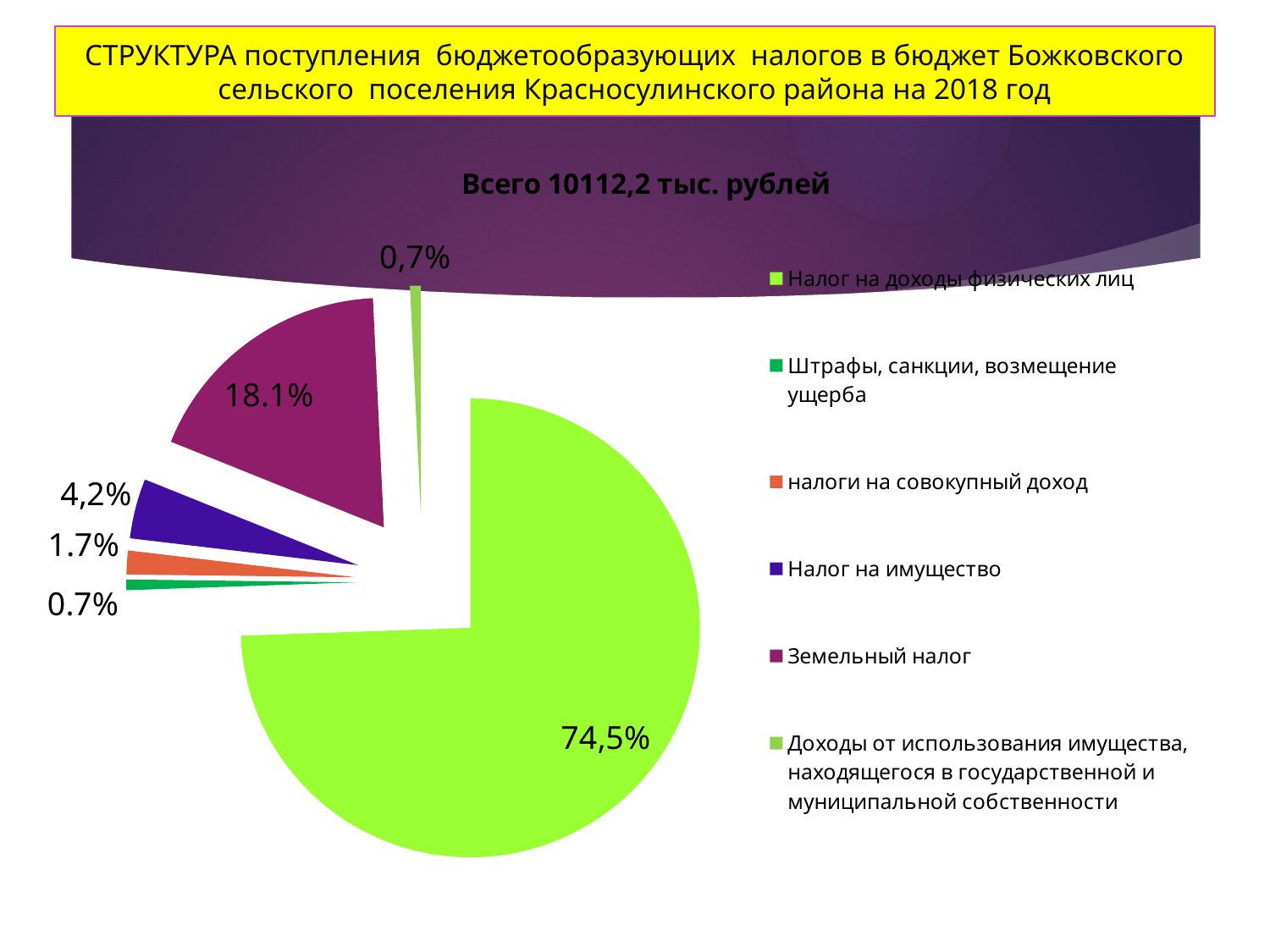
How many slices does the pie chart have? 6 Which is larger, Земельный налог or Налог на имущество? Земельный налог What share of the pie is налоги на совокупный доход? 1.7% Which category has the largest share of the pie? Налог на доходы физических лиц What is the chart's title? Всего 10112,2 тыс. рублей What share of the pie is Земельный налог? 18.1% What is the difference in percentage points between Земельный налог and Налог на имущество? 13.9 What share of the pie is Налог на имущество? 4,2% How many entries does the legend list? 6 Which legend entry is shown in orange? налоги на совокупный доход What kind of chart is shown on the slide? pie chart